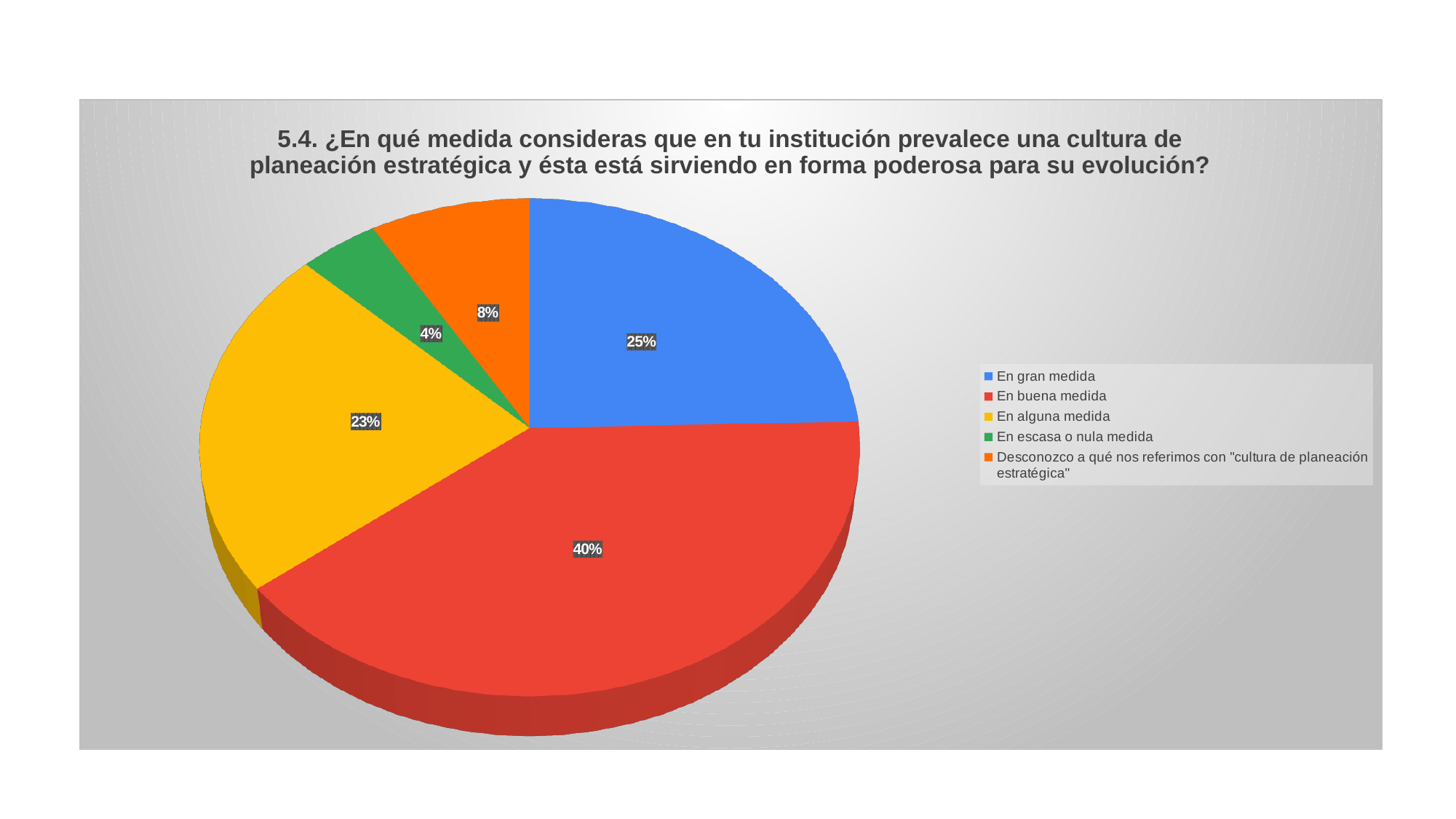
What type of chart is shown on the slide? Pie chart Which is larger: the share for "En alguna medida" or the share for "Desconozco a qué nos referimos con "cultura de planeación estratégica""? En alguna medida Which response category has the smallest share of the pie? En escasa o nula medida What percentage of respondents answered "En alguna medida"? 23% What percentage of respondents answered "En buena medida"? 40% What is the difference in percentage points between "En buena medida" and "En gran medida"? 15 What percentage of respondents answered "Desconozco a qué nos referimos con "cultura de planeación estratégica""? 8% What colour is the slice for "En alguna medida"? Yellow How many response categories does the legend list? 5 What percentage of respondents answered "En escasa o nula medida"? 4% What percentage of respondents answered "En gran medida"? 25% Which response category has the largest share of the pie? En buena medida